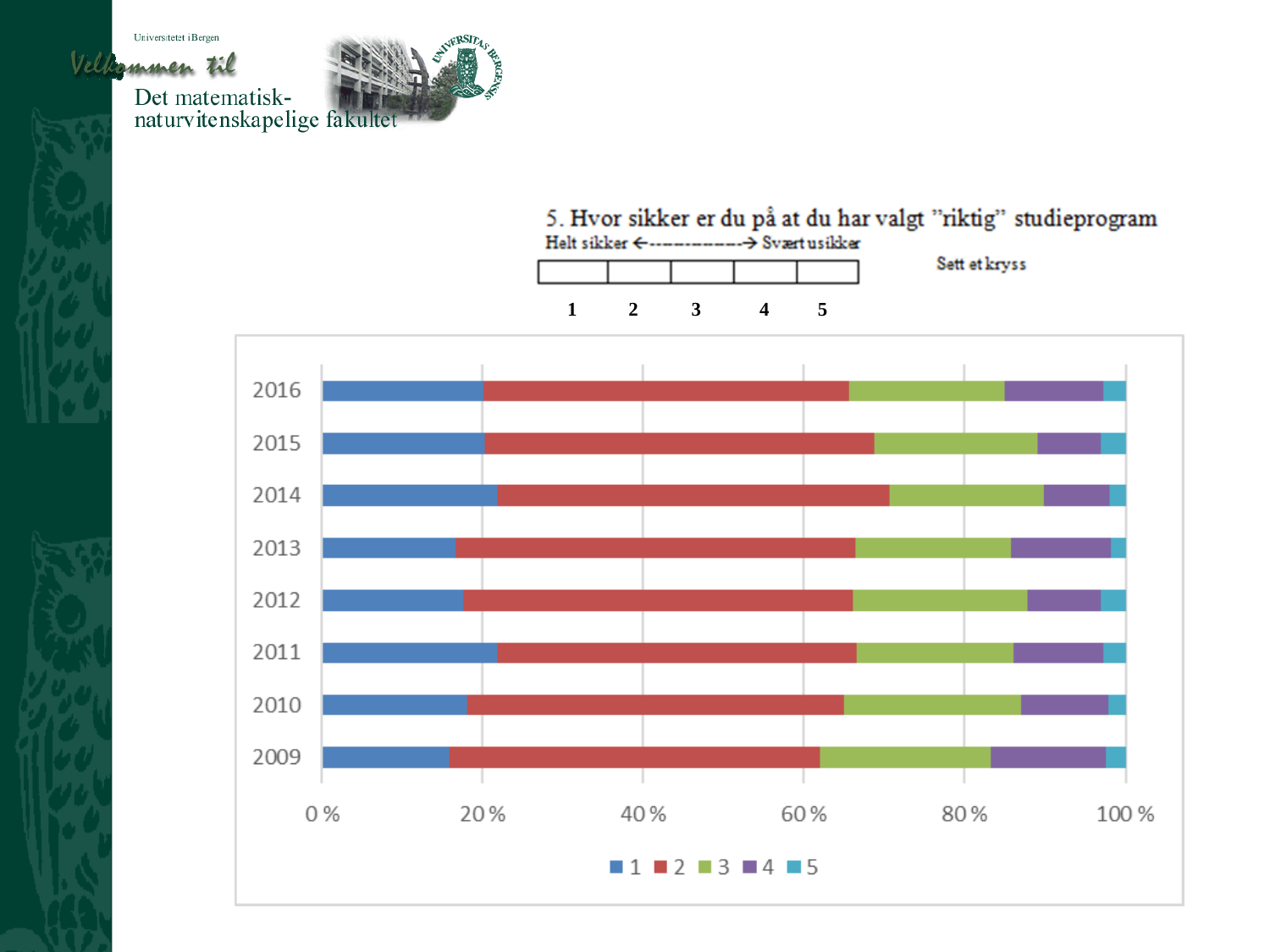
What is the total of the stacked bar for 2016? 100 % How many series does the chart legend list? 5 Is the value for series 1 in 2014 greater or less than 20%? greater Is the value for series 1 in 2009 greater or less than 20%? less What kind of chart is shown on the slide? Stacked bar chart How many years are shown on the vertical axis of the chart? 8 What are the legend entries of the chart? 1, 2, 3, 4, 5 Is the value for series 1 in 2013 greater or less than 20%? less Which year has the larger series 1 segment, 2014 or 2009? 2014 Which year has the larger series 1 segment, 2011 or 2013? 2011 What colour represents series 2 in the chart? Red